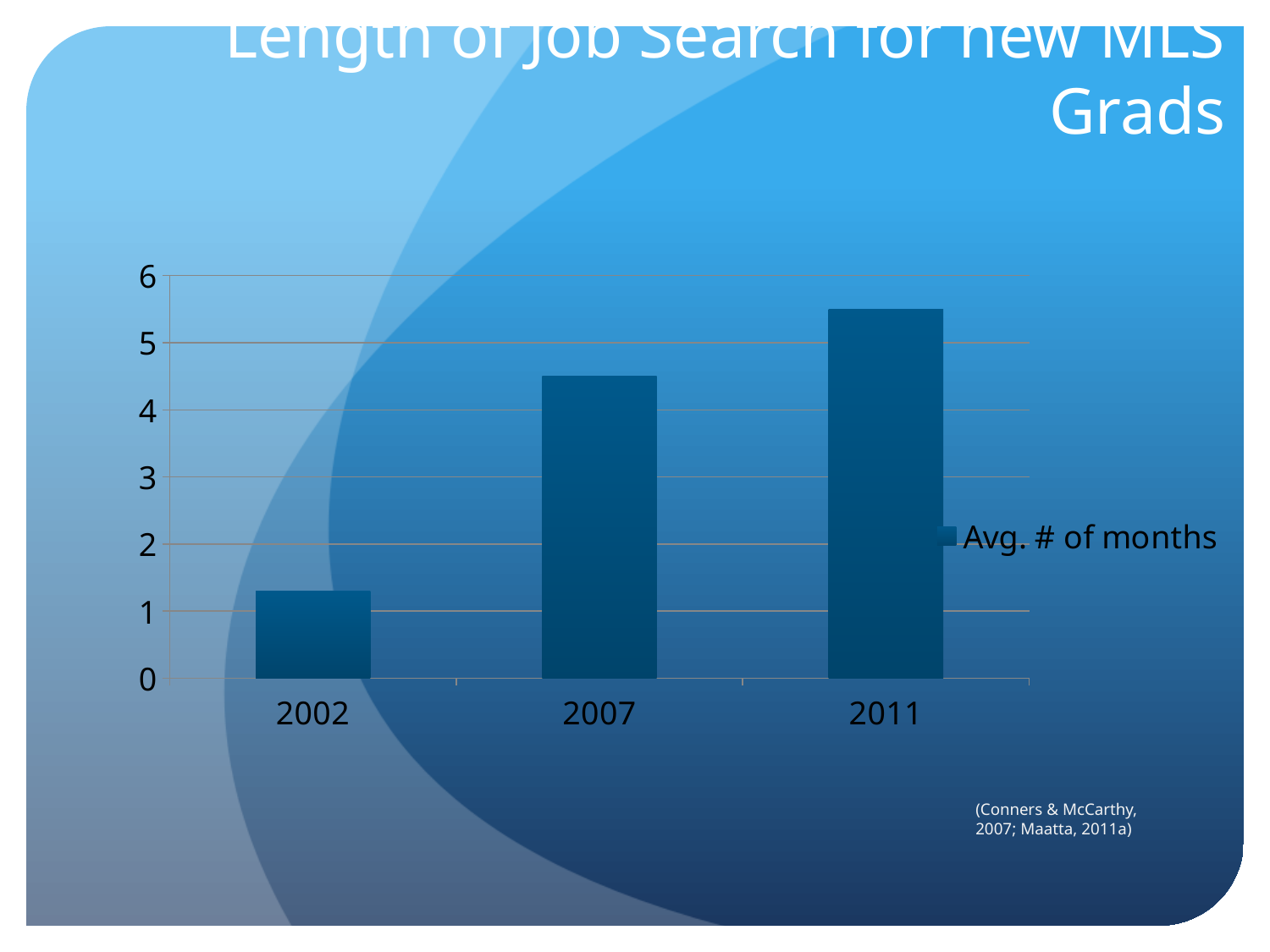
Is the value for 2002 greater or less than 2? less Is the value for 2011 greater or less than 5? greater Do the values rise or fall from 2002 to 2011? rise What is the name of the series shown in the chart's legend? Avg. # of months Is the value for 2007 greater or less than 4? greater How many series does the chart's legend list? 1 Which year has the lowest average number of months? 2002 What kind of chart is shown on the slide? bar chart Which year has the highest average number of months? 2011 Which is larger, the value for 2007 or the value for 2011? 2011 How many years are shown on the x axis of the chart? 3 What is the title of the chart on the slide? Length of Job Search for new MLS Grads